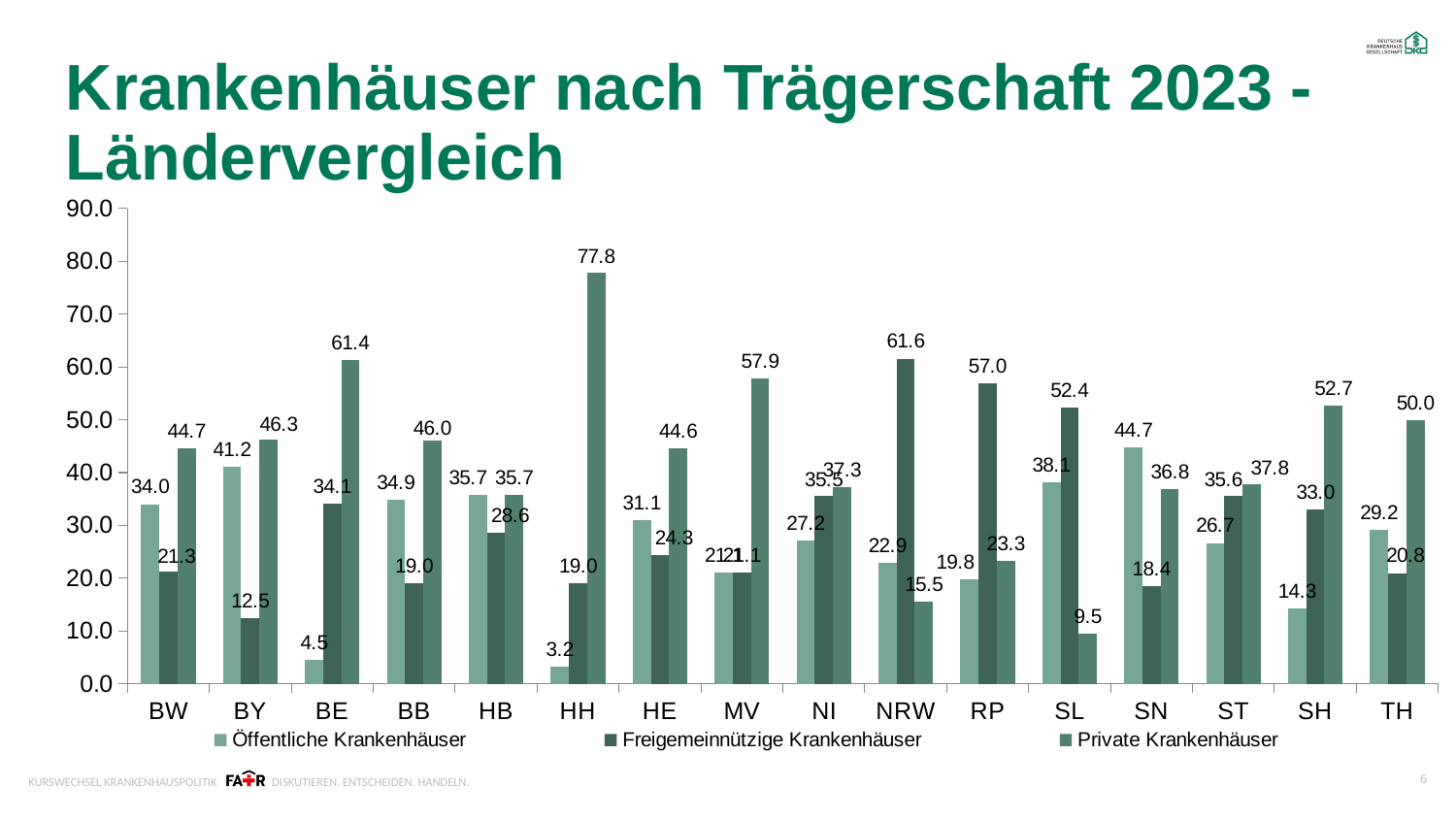
How many series does the legend list? 3 Which state has the highest value for Private Krankenhäuser? HH What is the difference between Private Krankenhäuser and Öffentliche Krankenhäuser in BE? 56.9 Which state has the highest value for Freigemeinnützige Krankenhäuser? NRW What are the three series named in the legend? Öffentliche Krankenhäuser, Freigemeinnützige Krankenhäuser, Private Krankenhäuser What is the value for Freigemeinnützige Krankenhäuser in SL? 52.4 What is the value for Öffentliche Krankenhäuser in BE? 4.5 What is the value for Private Krankenhäuser in HH? 77.8 What kind of chart is shown on the slide? bar chart How many federal states (categories) are shown on the x axis? 16 Which state has the lowest value for Öffentliche Krankenhäuser? HH In NRW, which is larger: Freigemeinnützige Krankenhäuser or Private Krankenhäuser? Freigemeinnützige Krankenhäuser